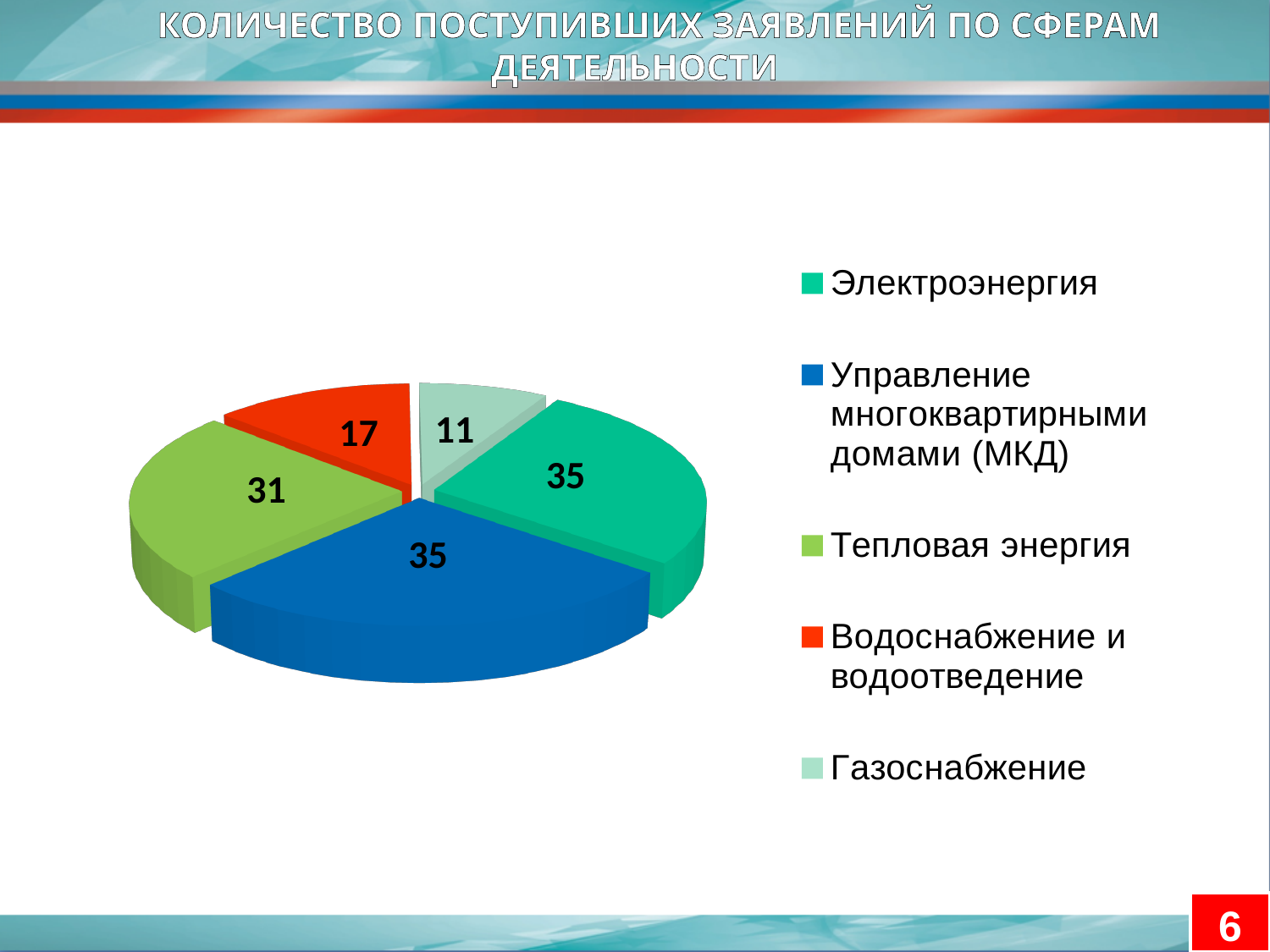
What is the difference between the values for Тепловая энергия and Водоснабжение и водоотведение? 14 What is the value for Электроэнергия? 35 Which category has the lowest value? Газоснабжение What is the value for Тепловая энергия? 31 What is the total of all the values in the pie chart? 129 How many categories does the pie chart have? 5 What type of chart is shown on the slide? pie chart What is the value for Водоснабжение и водоотведение? 17 What colour is the slice for Управление многоквартирными домами (МКД)? blue What is the difference between the values for Электроэнергия and Газоснабжение? 24 Which is larger, the value for Тепловая энергия or the value for Водоснабжение и водоотведение? Тепловая энергия What is the value for Газоснабжение? 11